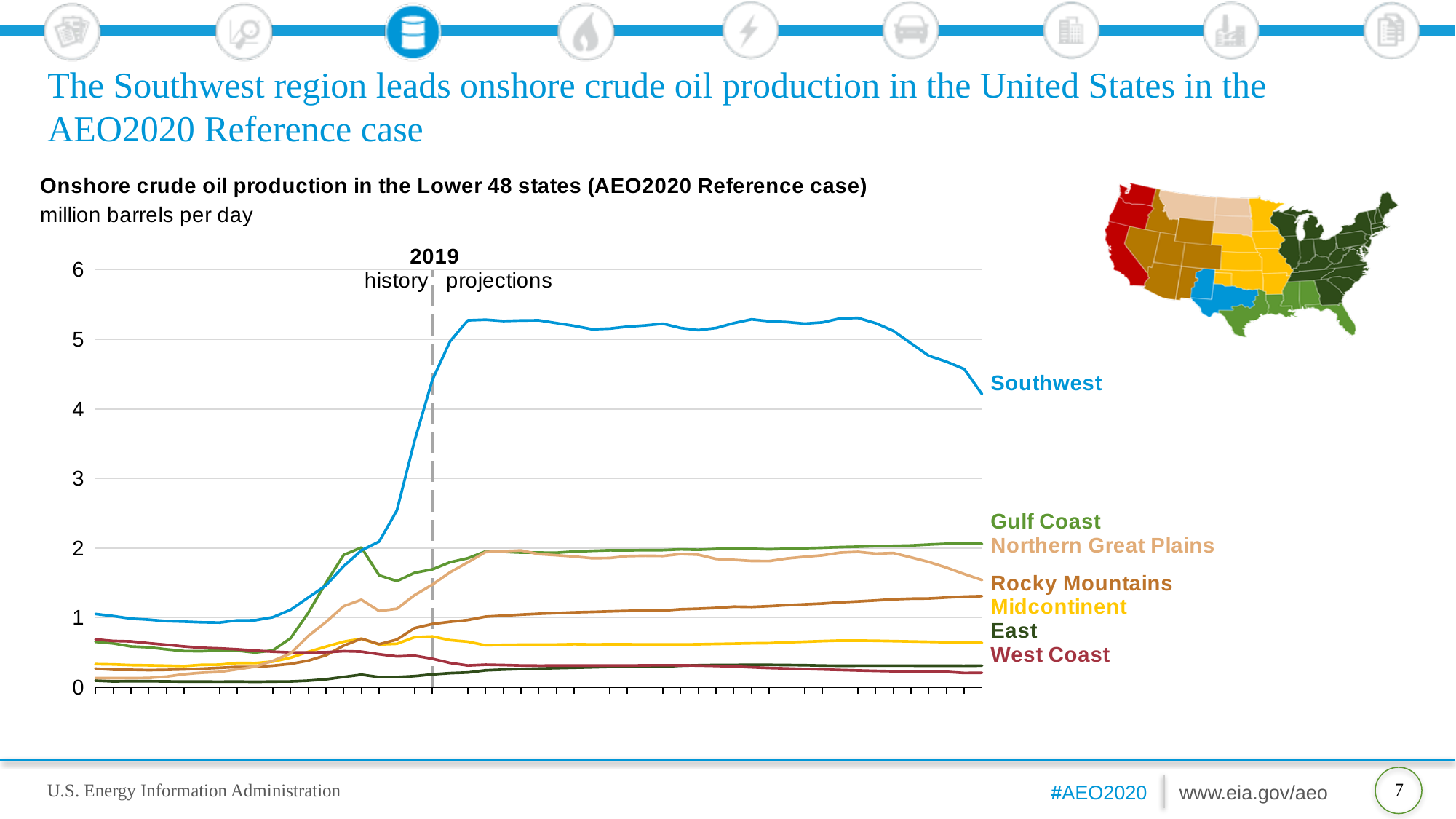
Is the Midcontinent region's production at the end of the projection period greater or less than 1 million barrels per day? less What unit is used on the chart's y axis? million barrels per day Which region has higher production at the end of the projection period, Rocky Mountains or Midcontinent? Rocky Mountains Is the Southwest region's production at the end of the projection period greater or less than 4 million barrels per day? greater What year does the dashed vertical line separating history from projections mark? 2019 How many regions (series) are plotted on the chart? 7 Does the Rocky Mountains region's production rise or fall over the projection period? rise Which region has the highest onshore crude oil production at the end of the projection period? Southwest Which region has higher production at the end of the projection period, Gulf Coast or Northern Great Plains? Gulf Coast What kind of chart is shown on the slide? line chart Which region has the lowest onshore crude oil production at the end of the projection period? West Coast Is the Gulf Coast region's production at the end of the projection period greater or less than 3 million barrels per day? less